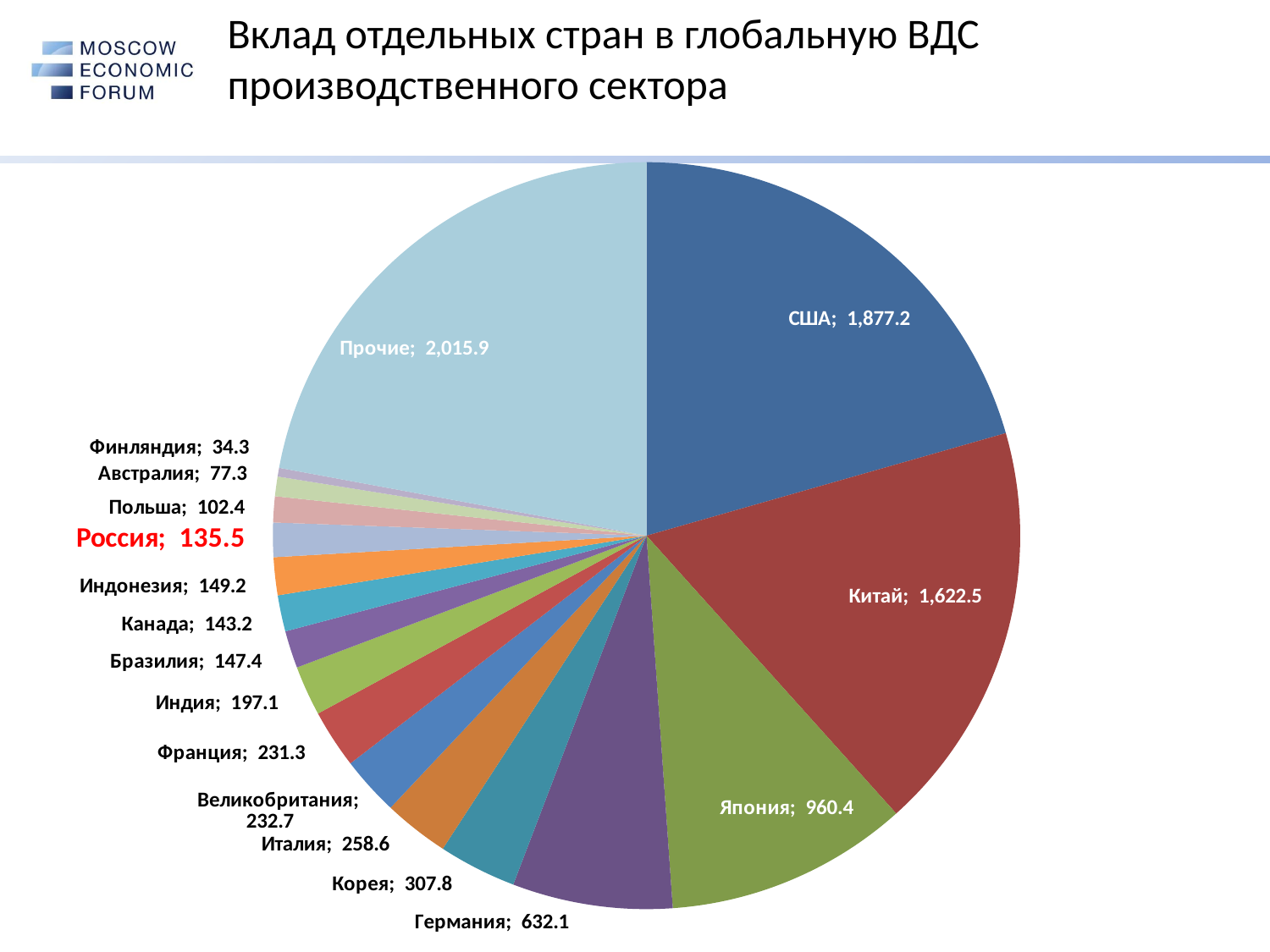
Which has a larger value, Корея or Италия? Корея What is the value for Германия (Germany) in the pie chart? 632.1 What is the value for Россия (Russia) in the pie chart? 135.5 Which individual country has the largest slice in the pie chart? США Which slice of the pie chart is the largest? Прочие What is the difference between the values for США and Китай? 254.7 Which category has the smallest slice in the pie chart? Финляндия What is the difference between the values for Япония and Германия? 328.3 What kind of chart is shown on the slide? pie chart What is the value for Индонезия (Indonesia) in the pie chart? 149.2 What is the value for США (USA) in the pie chart? 1,877.2 How many slices (categories) does the pie chart have? 17